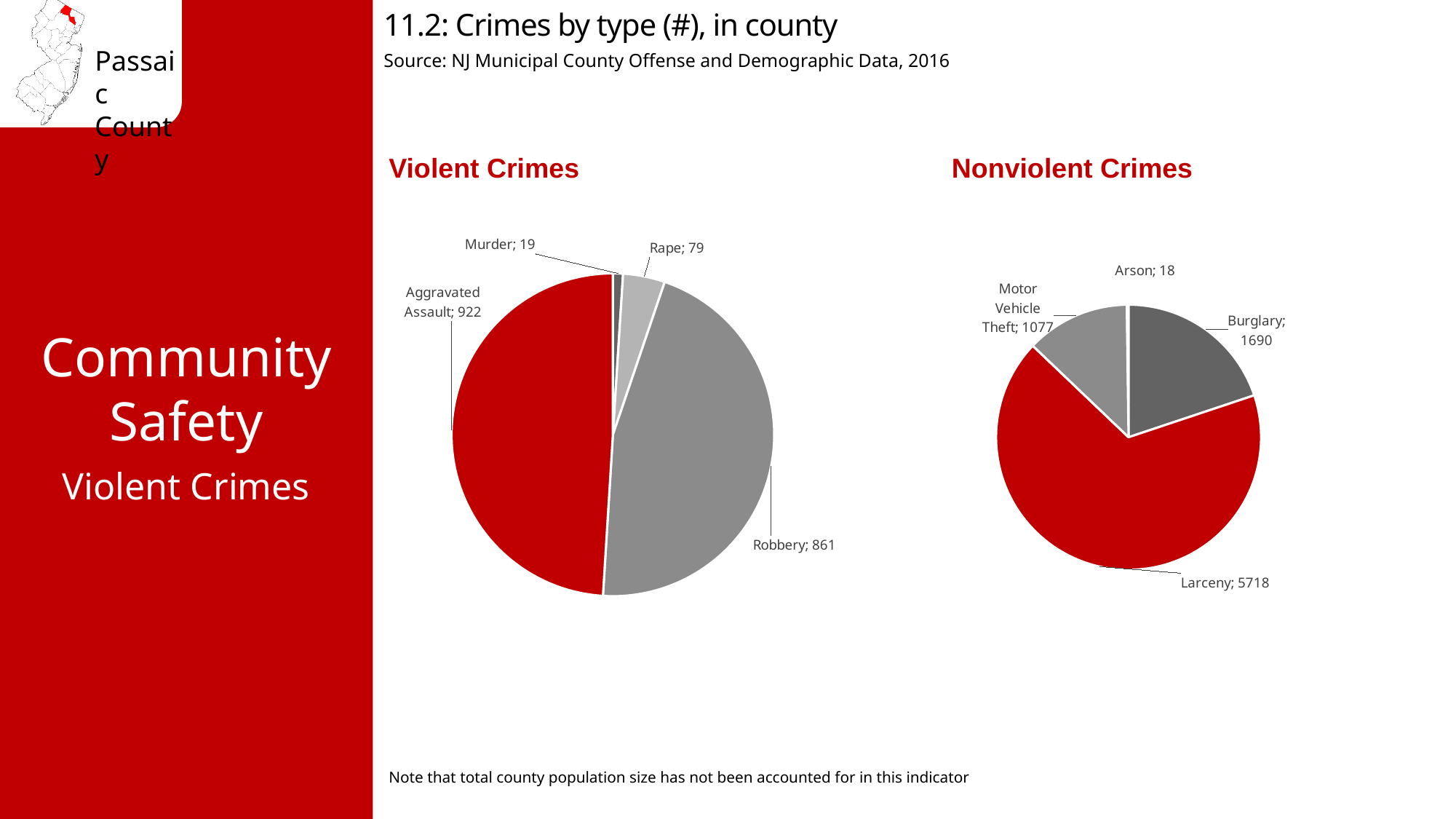
In the Nonviolent Crimes chart, which crime type has the smallest value? Arson In the Nonviolent Crimes chart, what is the difference between Burglary and Motor Vehicle Theft? 613 In the Nonviolent Crimes chart, what is the value for Larceny? 5718 In the Violent Crimes chart, how many aggravated assaults are shown? 922 In the Violent Crimes chart, which is larger, Rape or Murder? Rape In the Nonviolent Crimes chart, which crime type has the largest slice? Larceny In the Nonviolent Crimes chart, what is the value for Motor Vehicle Theft? 1077 What type of chart is used for Violent Crimes? Pie chart In the Violent Crimes chart, what is the value for Robbery? 861 In the Violent Crimes chart, which crime type has the smallest slice? Murder In the Violent Crimes chart, what is the difference between Aggravated Assault and Robbery? 61 How many categories does the Nonviolent Crimes chart show? 4